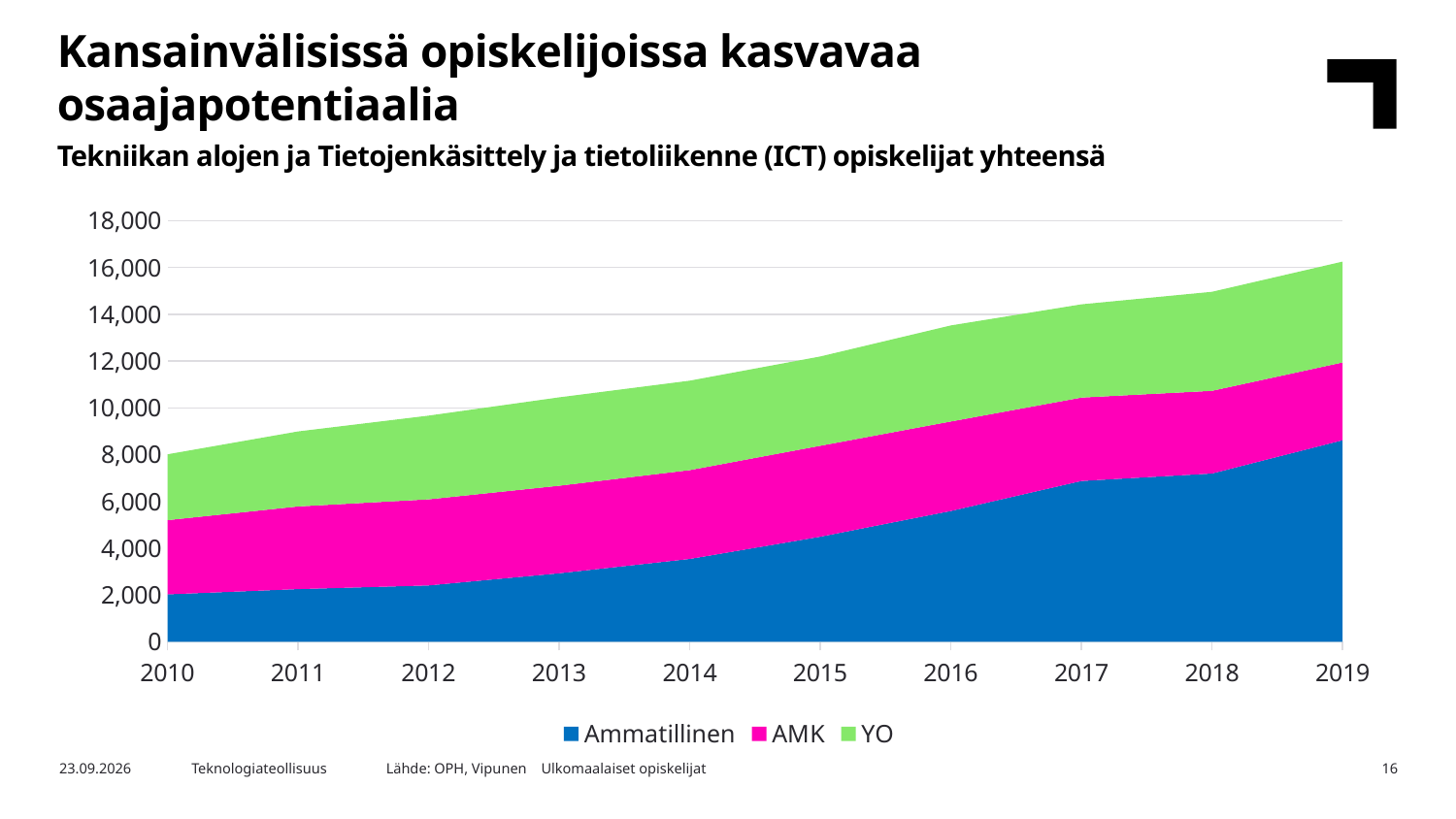
How many years are shown along the x axis? 10 Is the stacked total for 2019 greater or less than 16,000? greater Which year has the lowest stacked total? 2010 How many series does the legend list? 3 Which series is shown in blue? Ammatillinen Is the value for Ammatillinen in 2015 greater or less than 4,000? greater Is the stacked total for 2017 greater or less than 14,000? greater Which year has the highest stacked total? 2019 What kind of chart is shown on the slide? Stacked area chart Does the total number of students rise or fall from 2010 to 2019? Rise